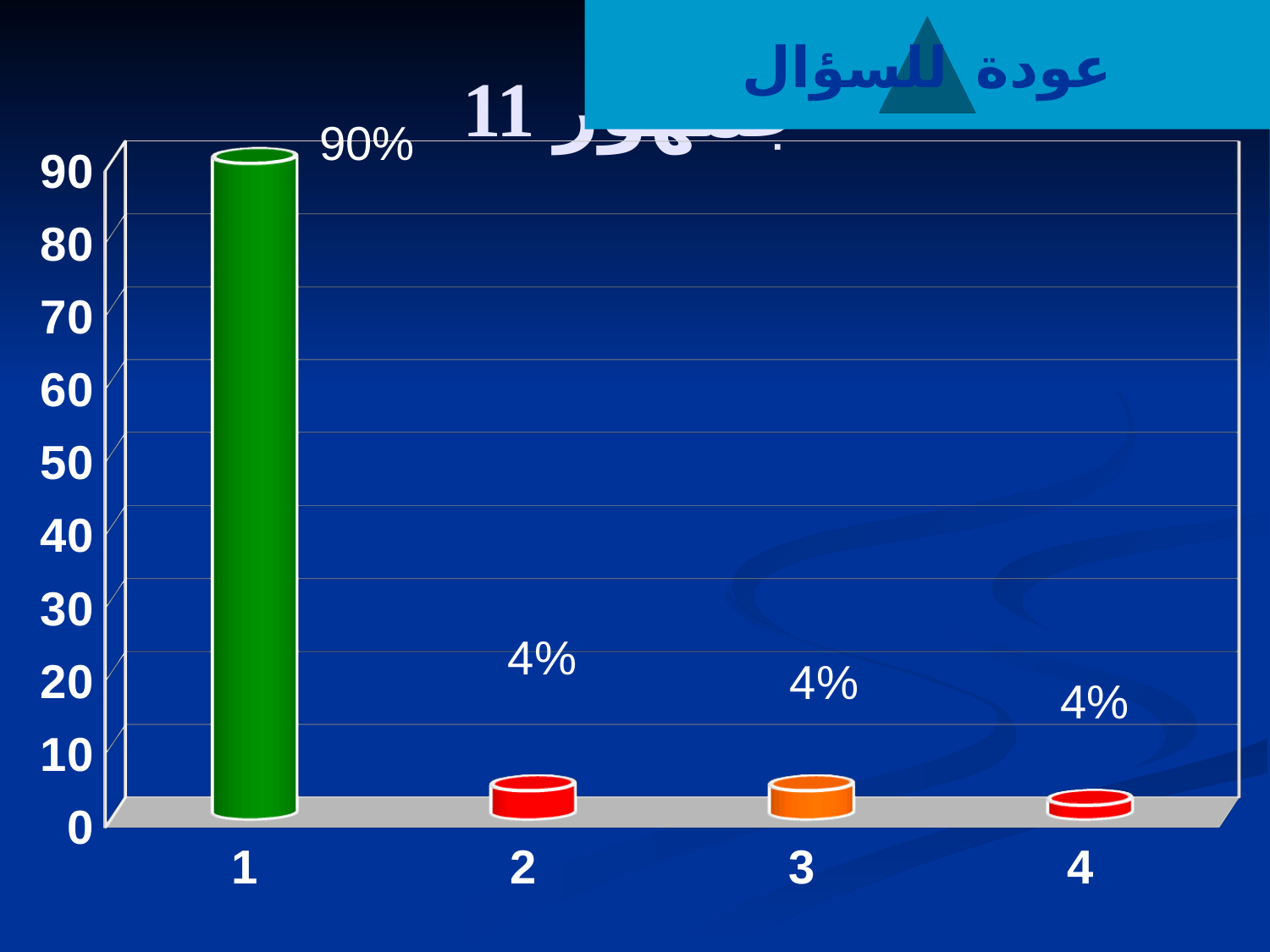
What is the value for category 3? 4% How many categories are shown on the x axis? 4 What is the value for category 1? 90% Is the value for category 1 greater or less than 50? greater What is the value for category 2? 4% What colour is the bar for category 1? green What is the difference between the values for category 1 and category 2? 86% What is the value for category 4? 4% Which is larger, the value for category 1 or the value for category 3? category 1 Is the value for category 4 greater or less than 10? less Which category has the highest value? 1 What kind of chart is shown on the slide? bar chart